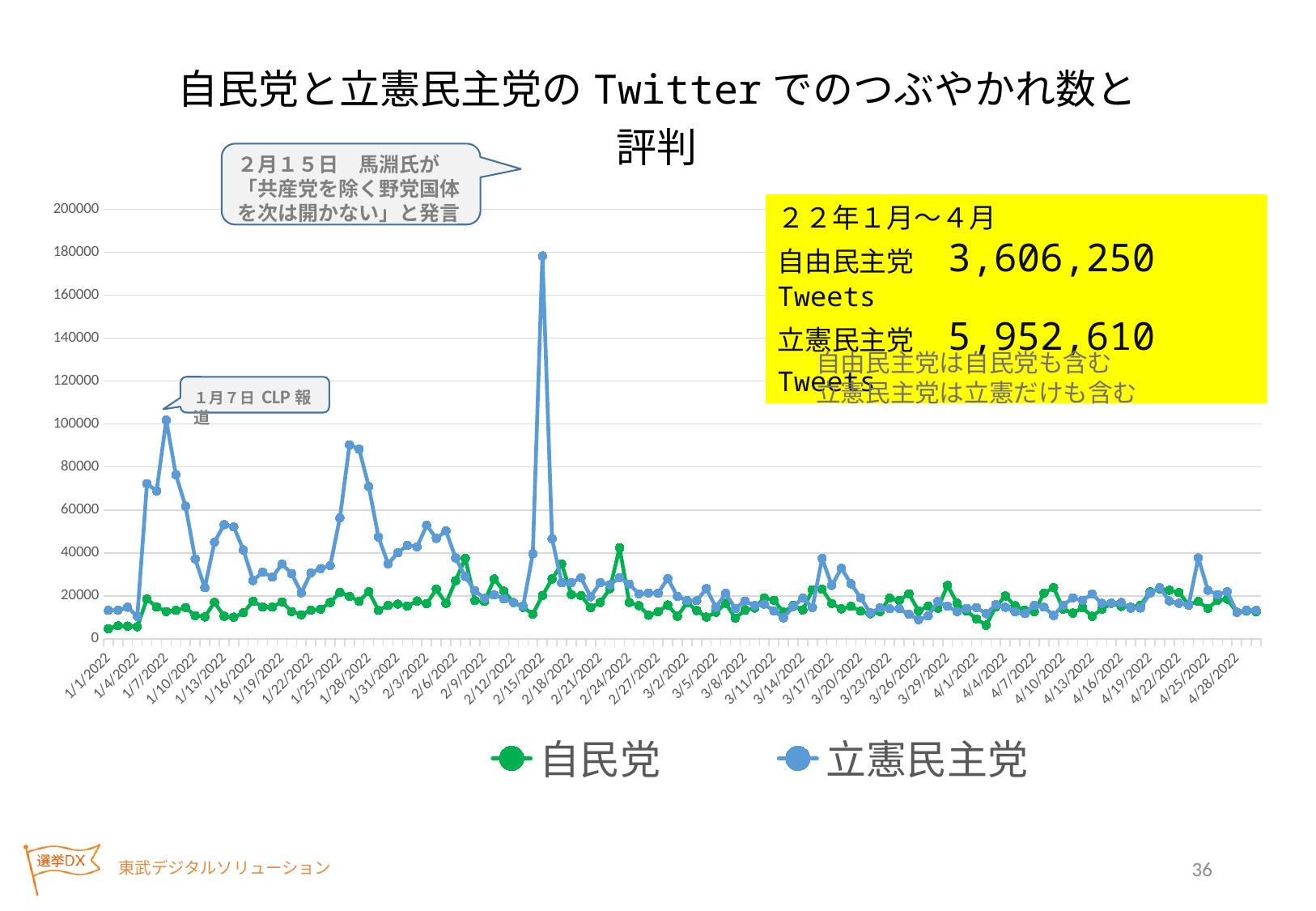
Is the value for 自民党 on 1/1/2022 greater or less than 20000? less Is the peak value for 立憲民主党 around 2/15/2022–2/18/2022 greater or less than 160000? greater Is the highest value for 自民党 (near 2/24/2022) greater or less than 30000? greater Which series is drawn in blue on the chart? 立憲民主党 Does the 立憲民主党 line rise or fall between its peak near 1/7/2022 and 1/13/2022? fall How many series does the chart's legend list? 2 Which series reaches the highest value anywhere on the chart? 立憲民主党 What kind of chart is shown on the slide? line chart Around 2/16/2022, which series has the larger value, 自民党 or 立憲民主党? 立憲民主党 Which two series are listed in the chart's legend? 自民党 and 立憲民主党